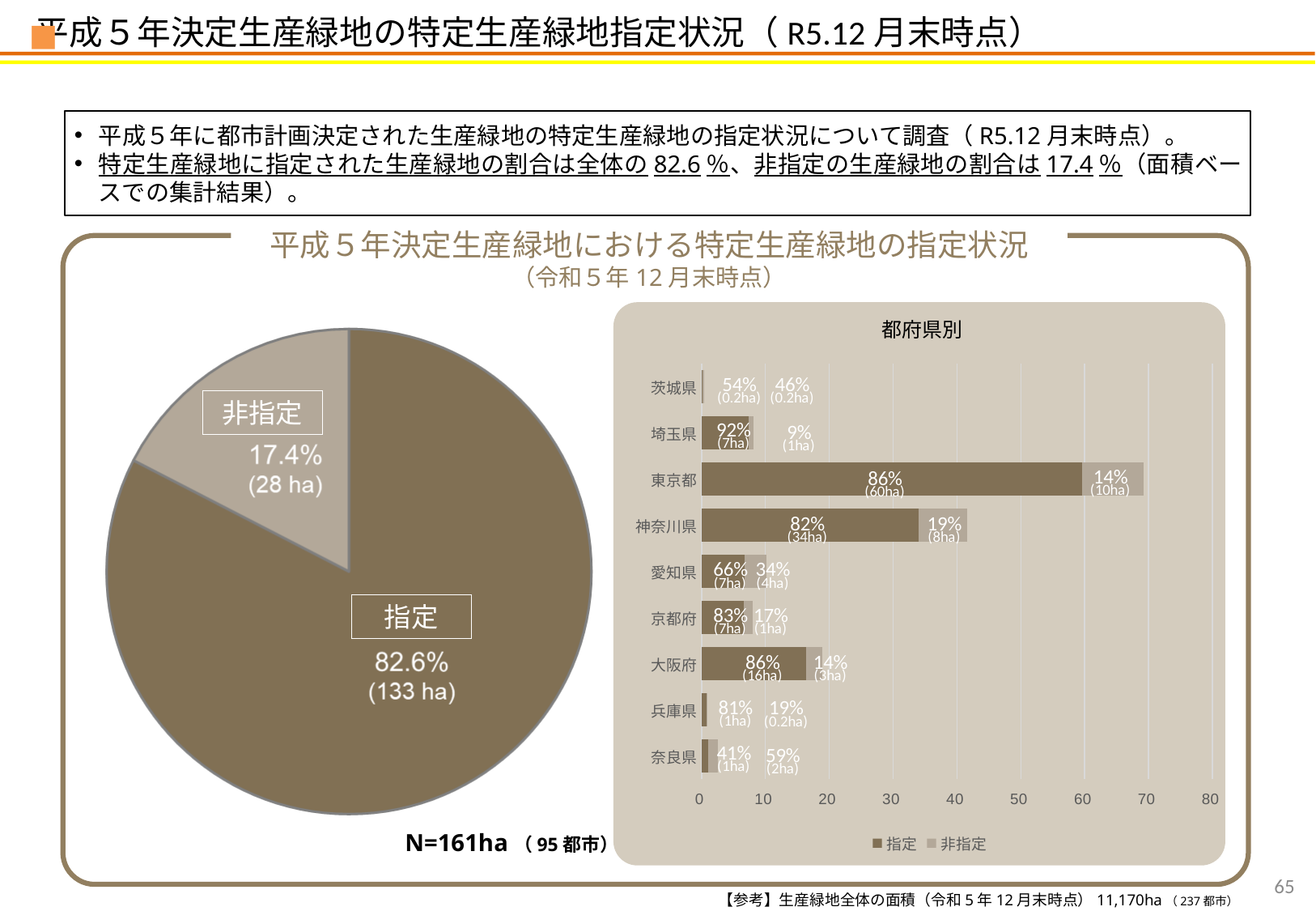
In the pie chart, which slice is larger, 指定 or 非指定? 指定 What kind of chart is the chart on the left of the slide? pie chart In the 都府県別 chart, how many series does the legend list? 2 In the 都府県別 chart, which has the larger 指定 area, 大阪府 or 愛知県? 大阪府 In the 都府県別 chart, what is the 非指定 percentage for 神奈川県? 19% In the 都府県別 chart, what is the 指定 area for 東京都? 60ha In the 都府県別 chart, what is the total area (指定 plus 非指定) for 東京都? 70ha What kind of chart is the 都府県別 chart on the right? bar chart In the 都府県別 chart, how many prefectures are listed? 9 In the pie chart, what area in hectares is shown for 非指定? 28 ha In the 都府県別 chart, which prefecture has the largest 指定 area? 東京都 In the pie chart, what share of the total is 指定? 82.6%